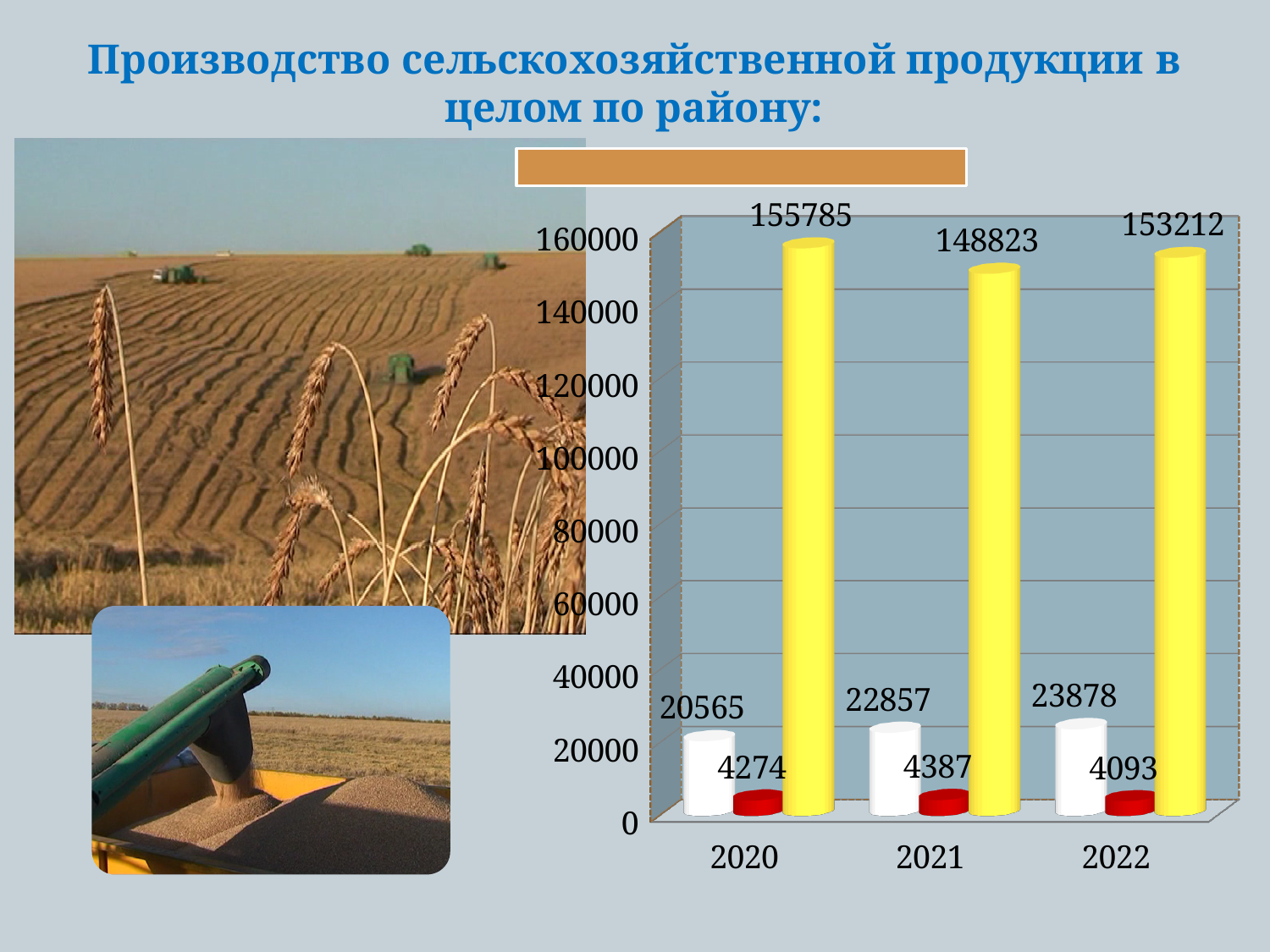
What is the value of the yellow bar for 2020? 155785 What is the difference between the yellow bar values for 2020 and 2021? 6962 Do the white bar values rise or fall from 2020 to 2022? rise In which year is the red bar lowest? 2022 Which is larger, the yellow bar for 2022 or the yellow bar for 2021? 2022 What is the difference between the white bar values for 2022 and 2020? 3313 Is the value of the white bar for 2021 greater or less than 20000? greater How many years are shown on the x axis? 3 What is the value of the white bar for 2022? 23878 What is the value of the red bar for 2021? 4387 What kind of chart is shown on the slide? bar chart In which year is the yellow bar highest? 2020